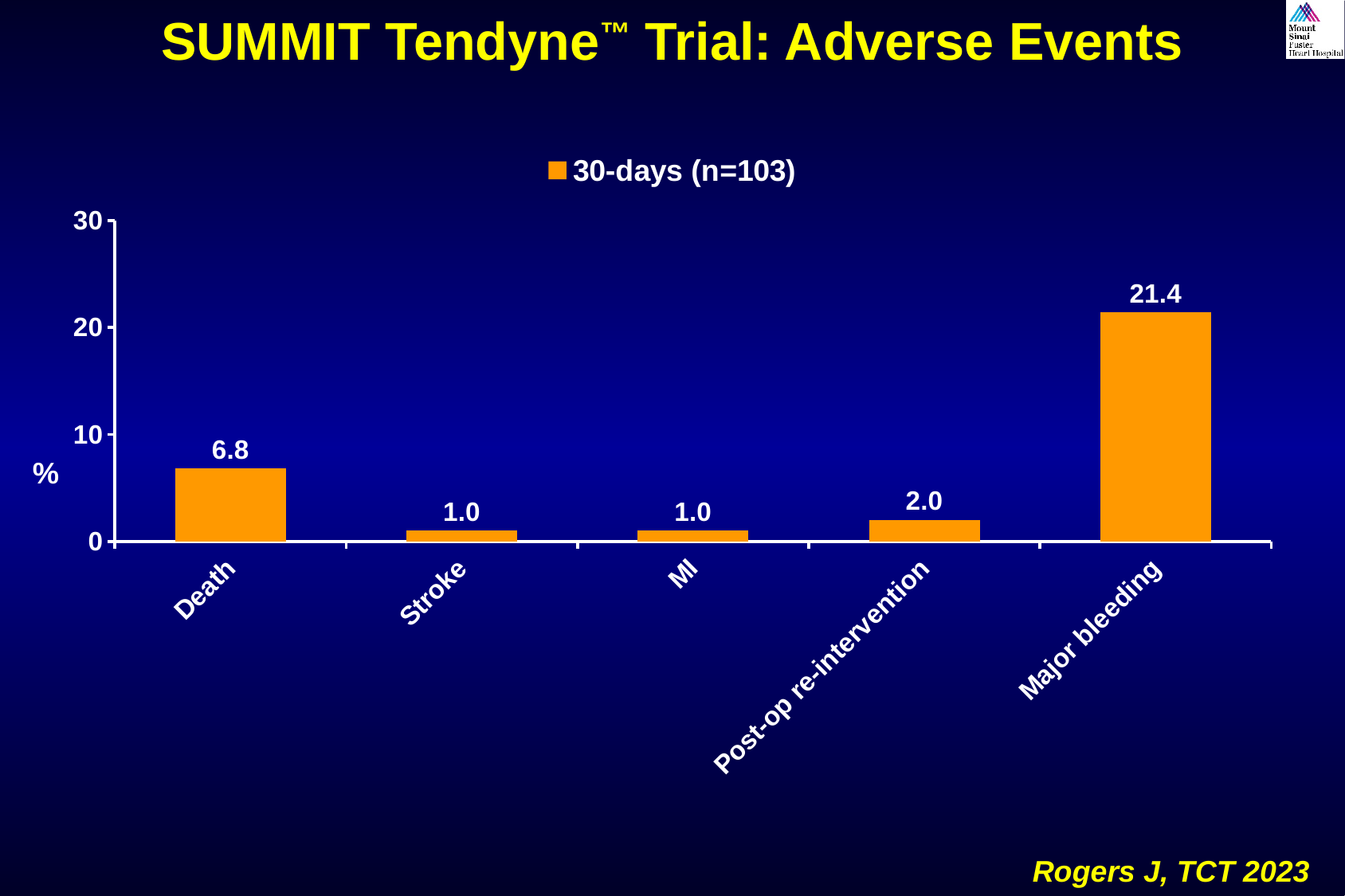
What kind of chart is shown? bar chart What is the value for Death? 6.8 What is the legend entry for the series? 30-days (n=103) What is the value for Post-op re-intervention? 2.0 How many series does the legend list? 1 What is the value for Stroke? 1.0 Which is larger, the value for Death or the value for Post-op re-intervention? Death What is the difference between the values for Major bleeding and Death? 14.6 Which category has the highest value? Major bleeding What is the value for Major bleeding? 21.4 How many categories are shown on the x axis? 5 Is the value for Major bleeding greater or less than 20? greater